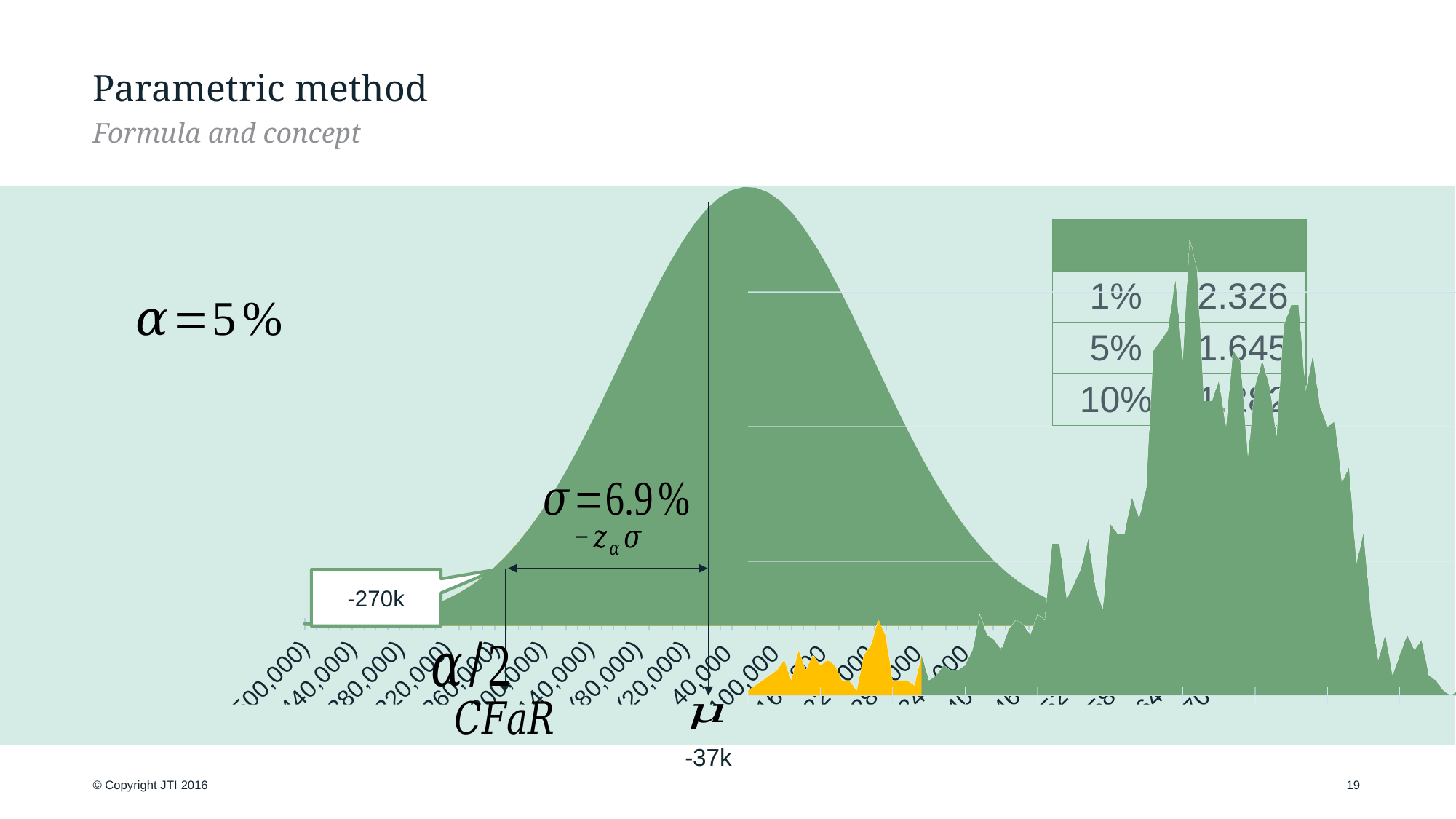
What kind of chart is the large bell-shaped chart on the slide? area chart What colour is the small jagged area near the bottom centre of the chart? yellow What value of σ is stated on the chart? 6.9% What label is written beneath the left vertical line on the bell curve, below α/2? CFaR How many rows of percentages does the table on the right list? 3 In the table on the right, what is the difference between the z-values for 1% and 5%? 0.681 In the table on the right, what z-value is listed for 5%? 1.645 What value is shown in the callout box on the left side of the bell curve? -270k What value of α is stated on the chart? 5% What value is labelled beneath the μ marker at the centre of the bell curve? -37k In the table on the right, what z-value is listed for 1%? 2.326 In the table on the right, which has the larger z-value, 1% or 5%? 1%